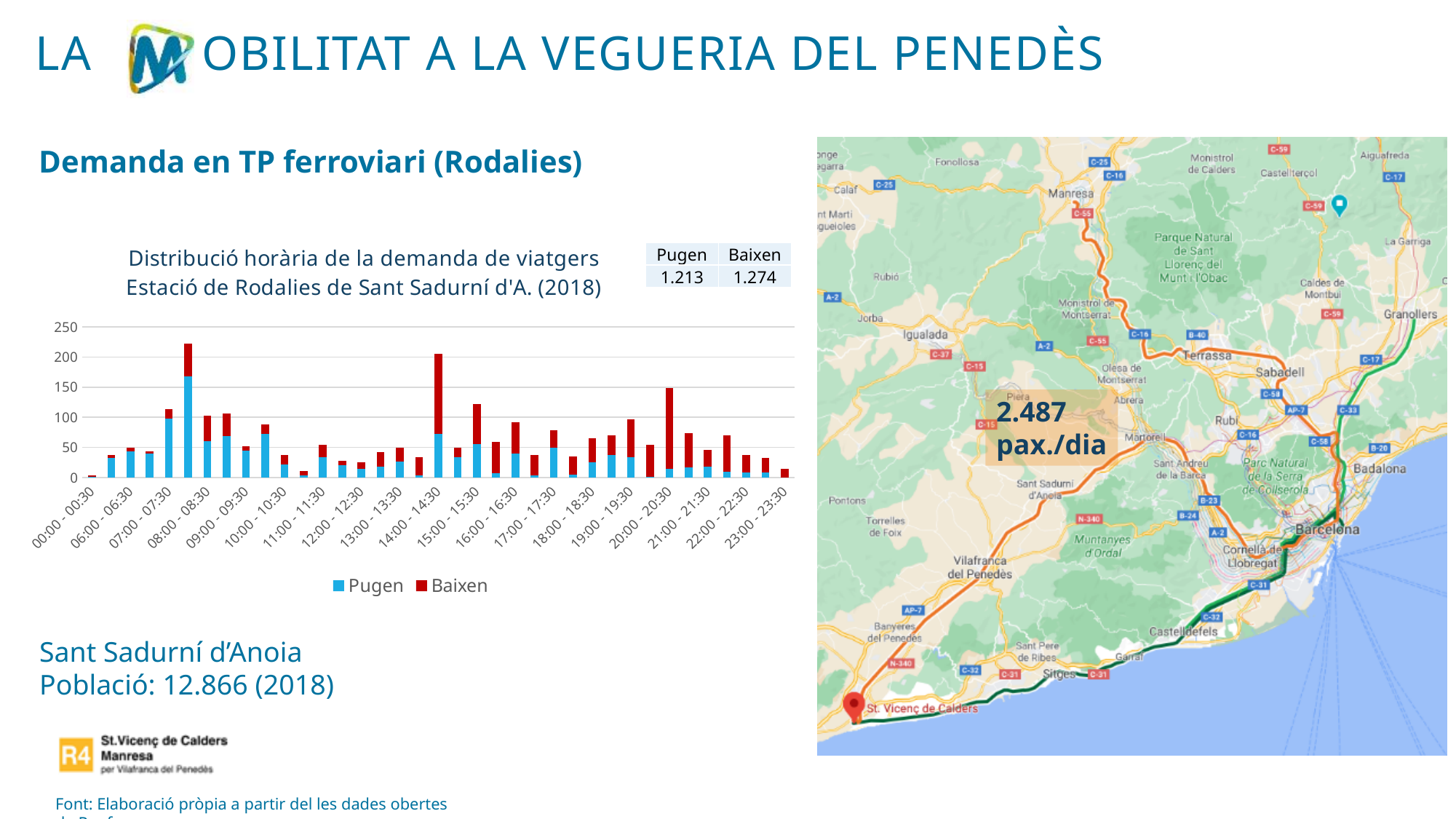
In the table next to the hourly demand chart, what is the total value for Baixen? 1.274 Is the total stacked value for 08:00 - 08:30 greater or less than 200? less Which colour represents the Baixen series in the hourly demand chart? red In the table next to the hourly demand chart, what is the total value for Pugen? 1.213 What kind of chart is used to show the hourly distribution of passenger demand at the Sant Sadurní d'A. station? bar chart Is the total stacked value for 00:00 - 00:30 greater or less than 50? less How many series does the legend of the hourly demand chart list? 2 Is the total stacked value for 16:00 - 16:30 greater or less than 100? less Which total is larger in the table next to the hourly demand chart, Pugen or Baixen? Baixen What is the difference between the Baixen total and the Pugen total shown in the table next to the hourly demand chart? 61 In the 08:00 - 08:30 bar, which series is larger, Pugen or Baixen? Pugen